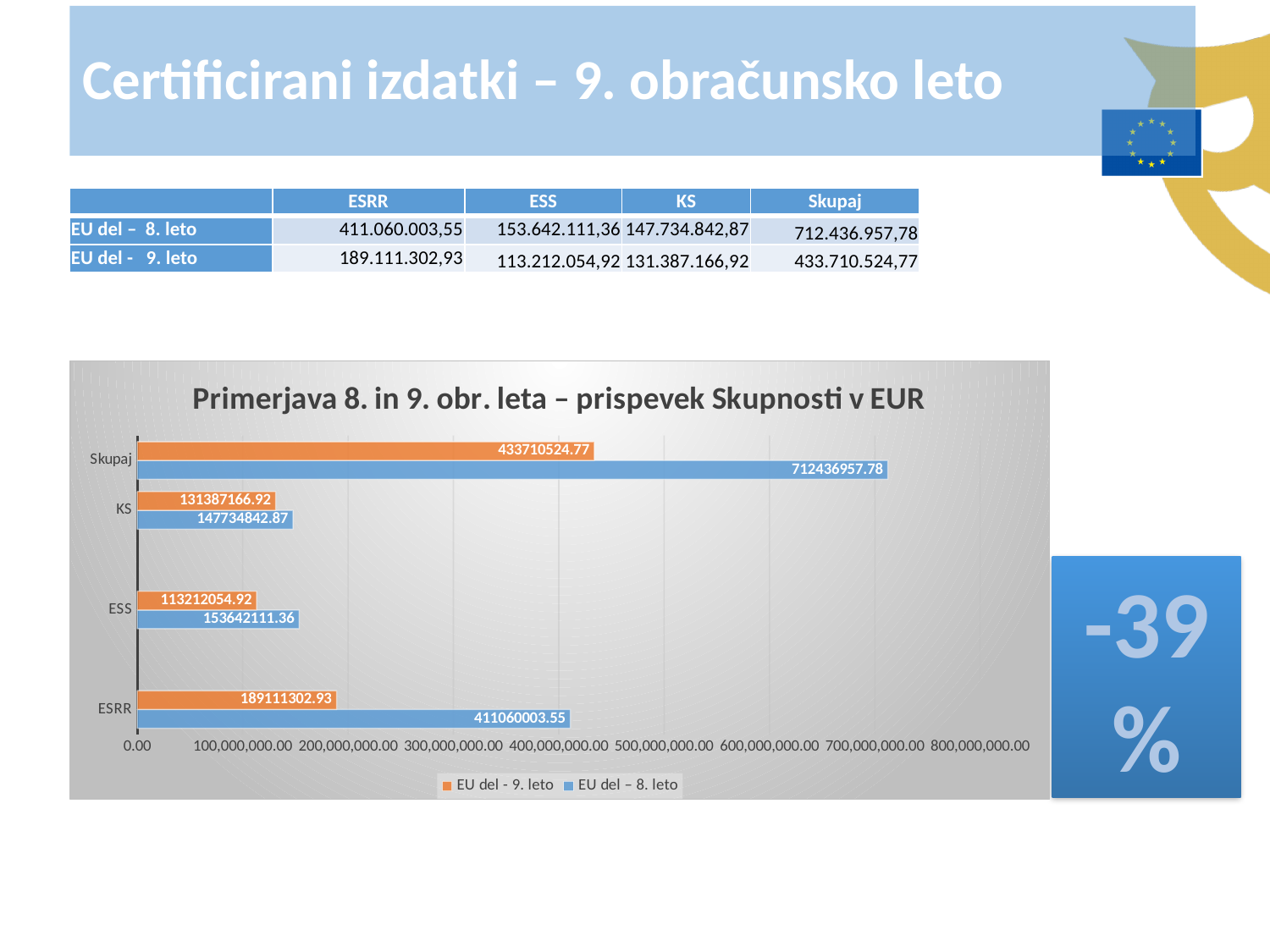
What is the value for ESS in the 'EU del - 9. leto' series? 113212054.92 What is the value for ESRR in the 'EU del – 8. leto' series? 411060003.55 Is the 'EU del – 8. leto' value for Skupaj greater or less than 700,000,000.00? greater How many series does the chart legend list? 2 What is the value for Skupaj in the 'EU del - 9. leto' series? 433710524.77 What type of chart is shown on the slide? bar chart How many categories are shown on the chart's vertical axis? 4 What is the value for KS in the 'EU del – 8. leto' series? 147734842.87 Which is larger for ESRR: the 'EU del - 9. leto' value or the 'EU del – 8. leto' value? EU del – 8. leto Which category has the lowest value in the 'EU del - 9. leto' series? ESS What is the difference between the 'EU del – 8. leto' and 'EU del - 9. leto' values for ESRR? 221948700.62 What is the title of the chart? Primerjava 8. in 9. obr. leta – prispevek Skupnosti v EUR